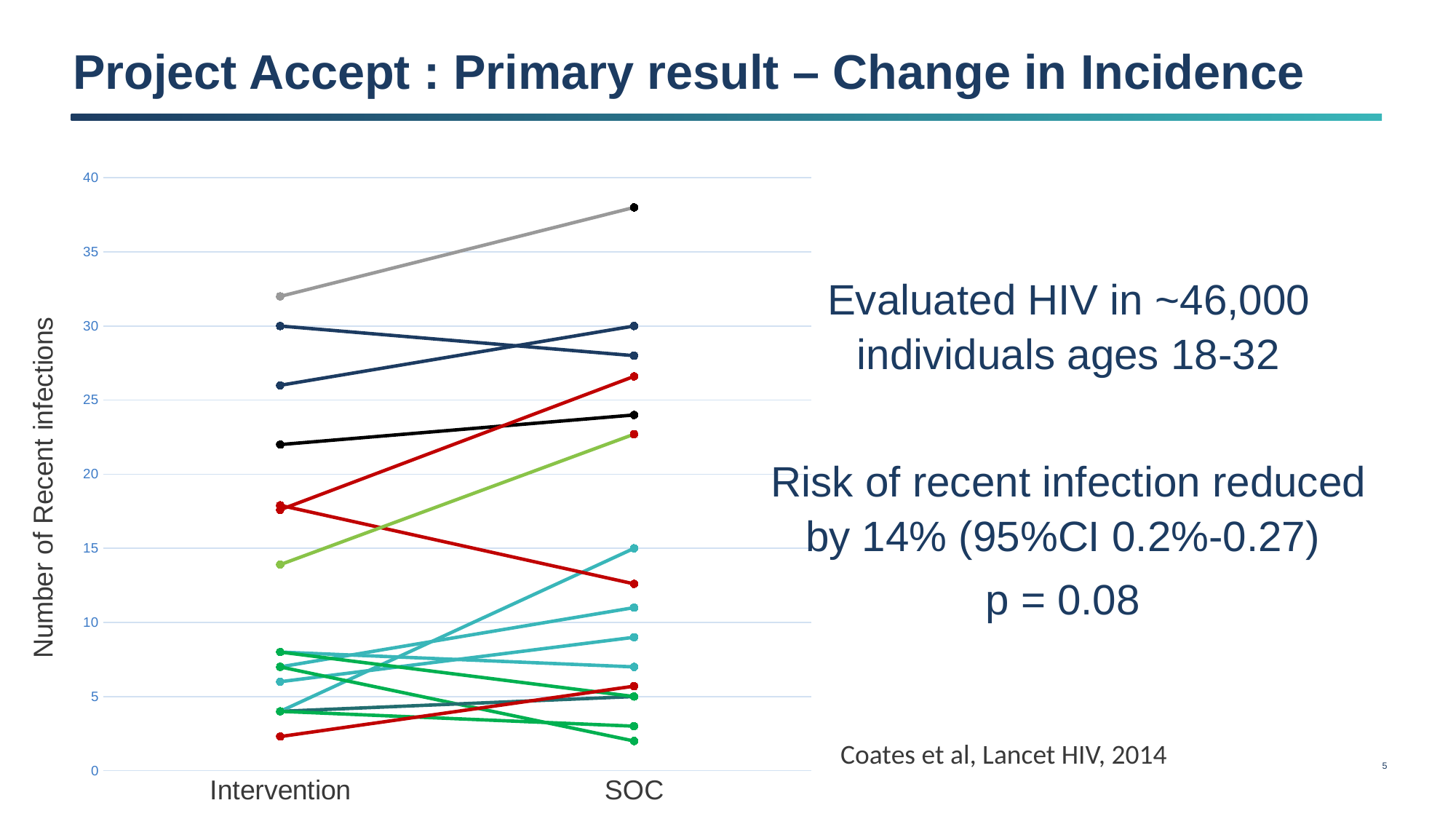
Is the lowest plotted value at Intervention greater or less than 5? less Does the topmost line (the one ending at the highest point at SOC) rise or fall from Intervention to SOC? rise What is the highest tick value shown on the y axis? 40 How many categories are shown on the x axis of the chart? 2 What kind of chart is shown on the slide? line chart Which category, Intervention or SOC, contains the highest single plotted value? SOC What is the label of the y axis of the chart? Number of Recent infections Is the lowest plotted value at SOC greater or less than 5? less Is the highest plotted value at SOC greater or less than 35? greater What are the two categories on the x axis of the chart? Intervention and SOC